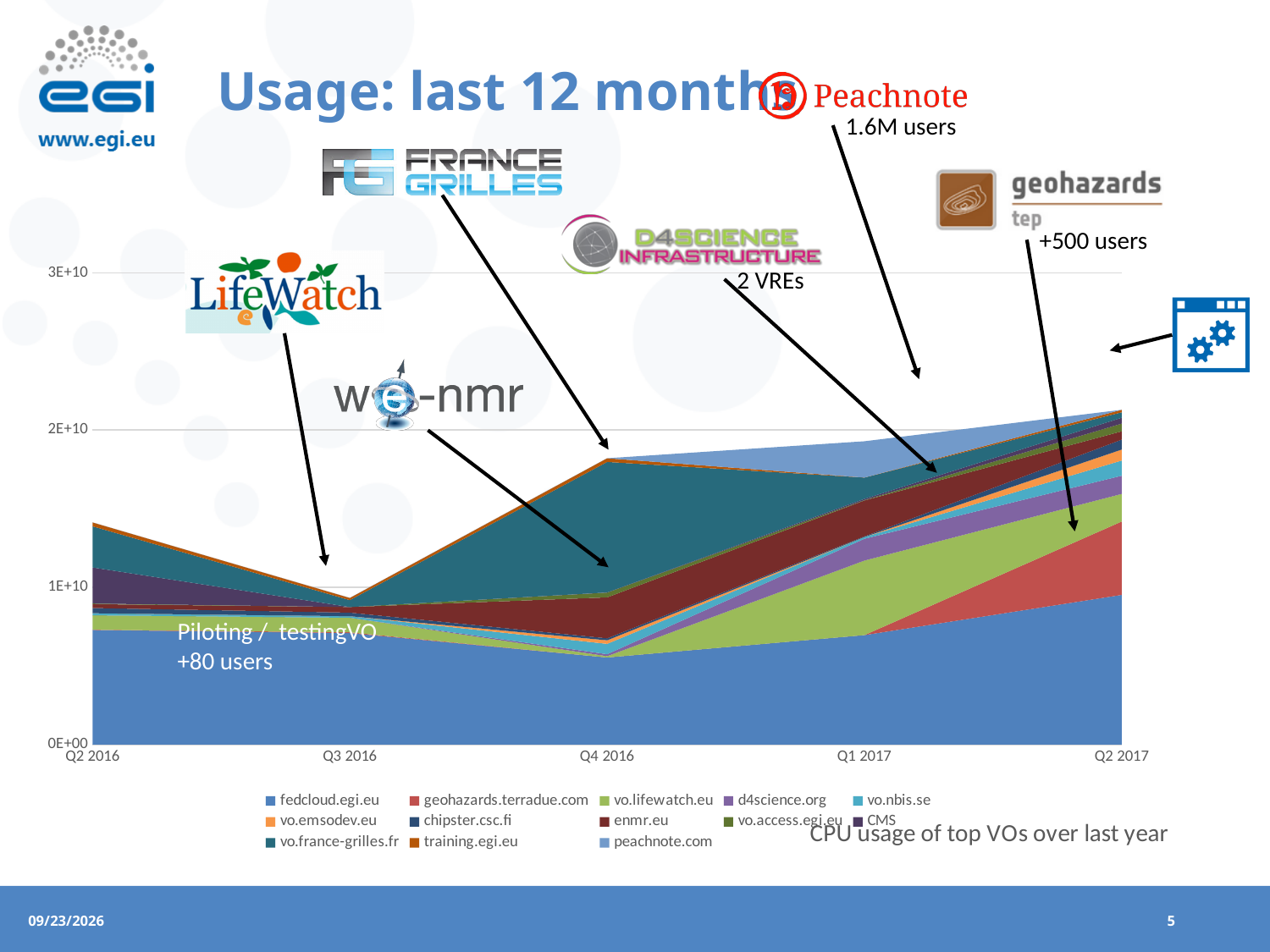
Is the total CPU usage for Q2 2017 greater or less than 2E+10? greater What kind of chart is shown on the slide? Stacked area chart Is the total CPU usage for Q2 2016 greater or less than 1E+10? greater Does the total CPU usage rise or fall from Q3 2016 to Q2 2017? rise What caption is written below the chart legend describing the chart? CPU usage of top VOs over last year Is the total CPU usage for Q4 2016 greater or less than 2E+10? less Which quarter has the lowest total CPU usage in the chart? Q3 2016 How many quarters are plotted along the x axis of the chart? 5 Which quarter has the highest total CPU usage in the chart? Q2 2017 How many series does the chart legend list? 13 Which quarter has the larger total CPU usage, Q2 2016 or Q3 2016? Q2 2016